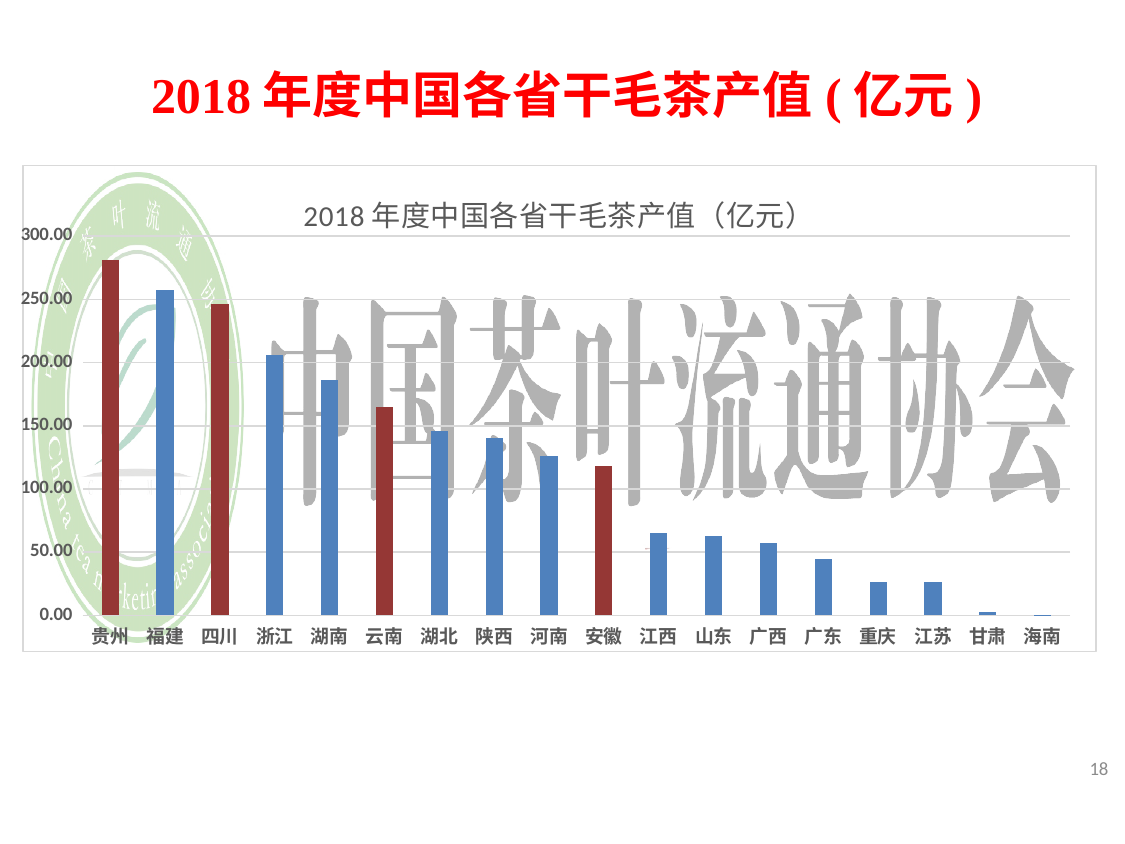
Which province has the highest dry tea output value in the chart? 贵州 Is the value for 安徽 greater or less than 150.00? less Is the value for 浙江 greater or less than 200.00? greater Which has a larger value, 福建 or 湖南? 福建 How many provinces are shown on the x axis of the chart? 18 Is the value for 贵州 greater or less than 250.00? greater Do the values generally rise or fall moving from left to right along the x axis? fall What kind of chart is shown on the slide? bar chart Which province has the lowest dry tea output value in the chart? 海南 Which has a larger value, 广东 or 云南? 云南 What is the title of the chart? 2018 年度中国各省干毛茶产值（亿元）